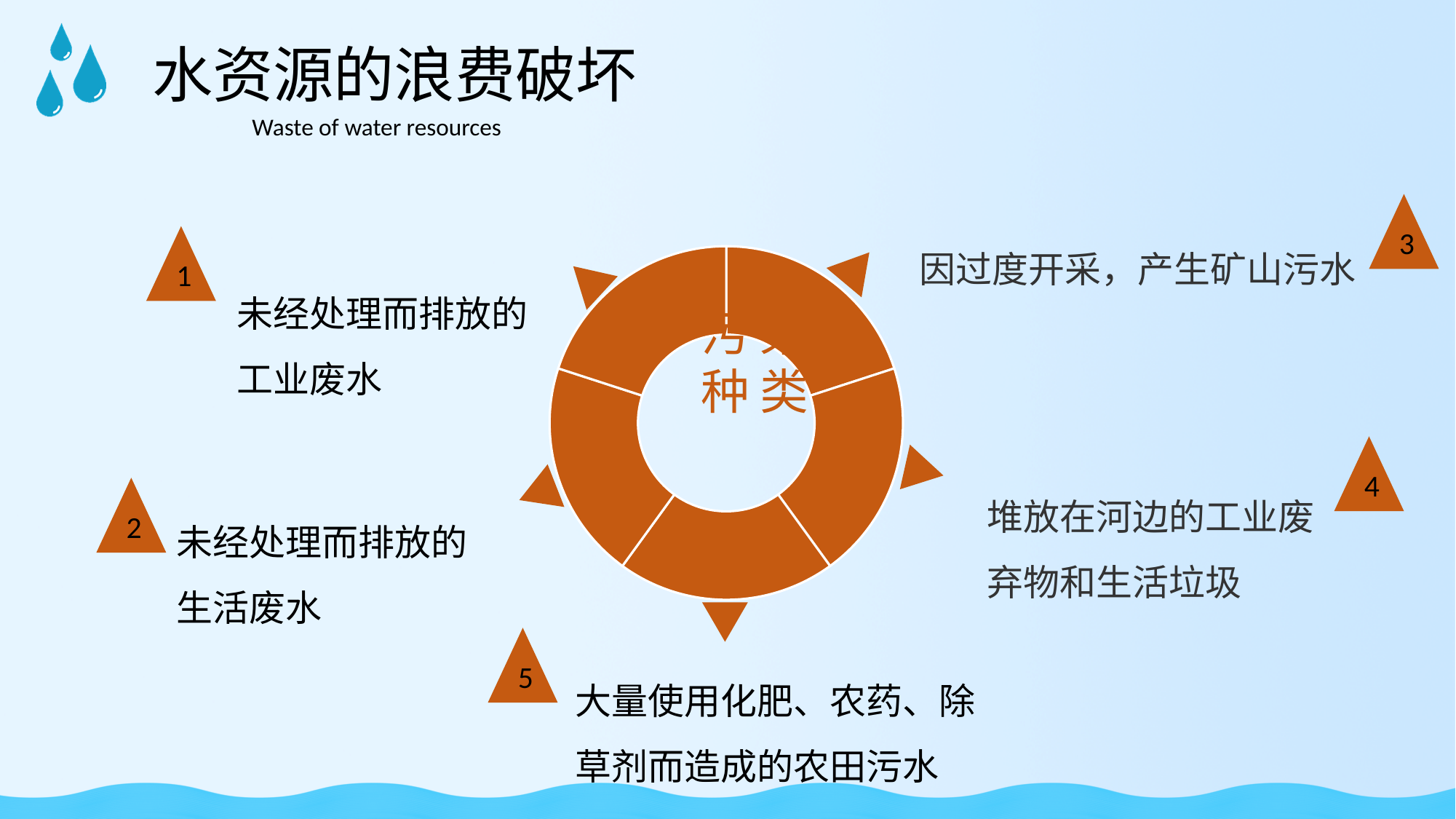
How many numbered triangle markers are placed around the ring diagram? 5 What text is attached to marker 2? 未经处理而排放的生活废水 What shape is the central diagram on the slide? a ring (donut) divided into segments What colour are the segments of the ring diagram? orange-brown What text is attached to marker 4? 堆放在河边的工业废弃物和生活垃圾 What text is attached to marker 1? 未经处理而排放的工业废水 Which numbered item is labelled '大量使用化肥、农药、除草剂而造成的农田污水'? 5 What text is attached to marker 3? 因过度开采，产生矿山污水 How many segments does the ring diagram in the centre of the slide have? 5